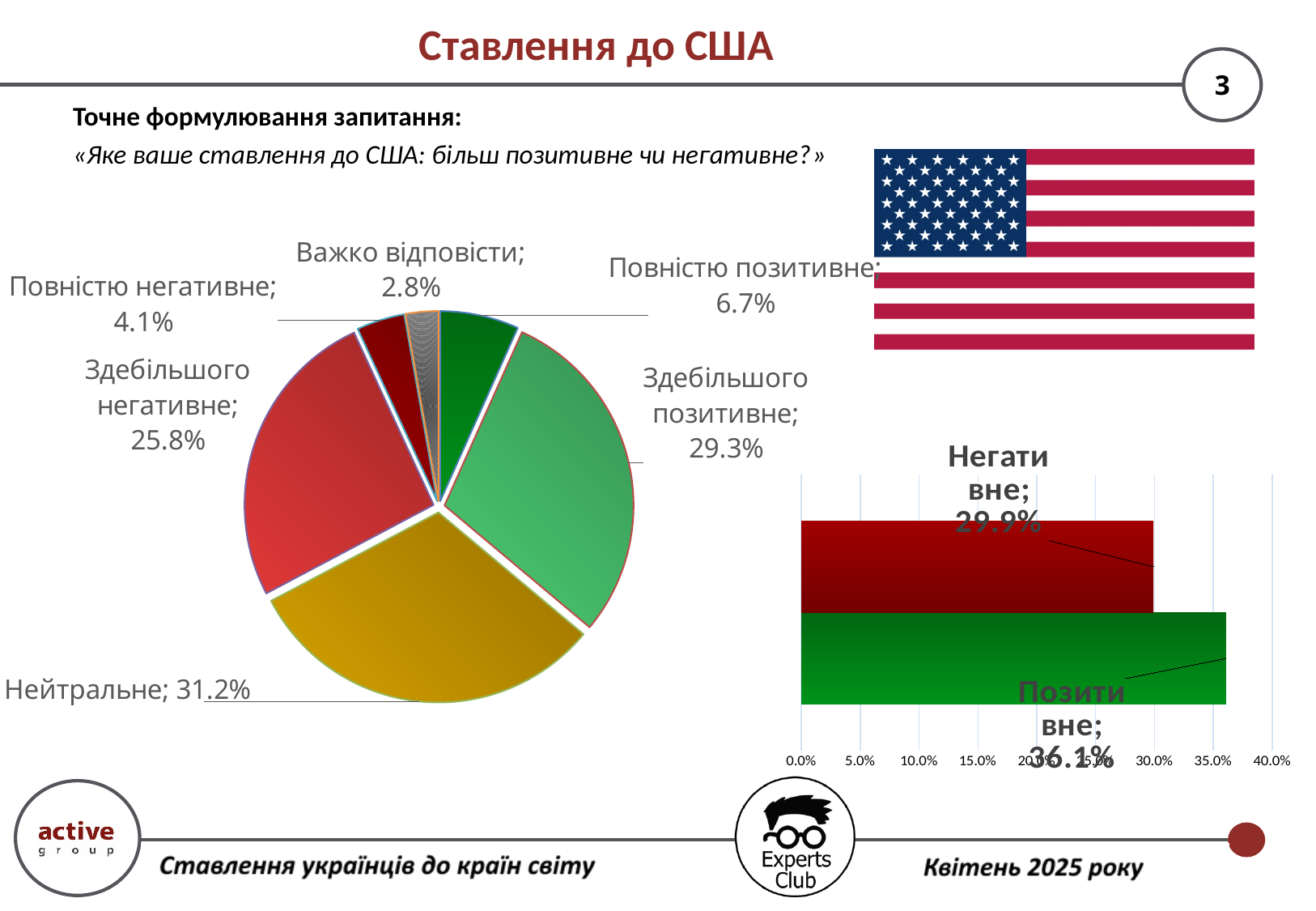
What kind of chart is the chart on the left of the slide? pie chart On the pie chart, what is the difference between «Здебільшого позитивне» and «Здебільшого негативне»? 3.5% How many slices does the pie chart have? 6 On the pie chart, which category has the smallest slice? Важко відповісти On the bar chart at the bottom right, what is the value for «Позитивне»? 36.1% On the bar chart at the bottom right, what is the difference between «Позитивне» and «Негативне»? 6.2% On the pie chart, which category has the largest slice? Нейтральне On the pie chart, what share is labelled for «Нейтральне»? 31.2% On the bar chart at the bottom right, what is the value for «Негативне»? 29.9% On the pie chart, which is larger: «Повністю позитивне» or «Повністю негативне»? Повністю позитивне On the pie chart, what share is labelled for «Здебільшого позитивне»? 29.3% On the pie chart, what share is labelled for «Повністю негативне»? 4.1%